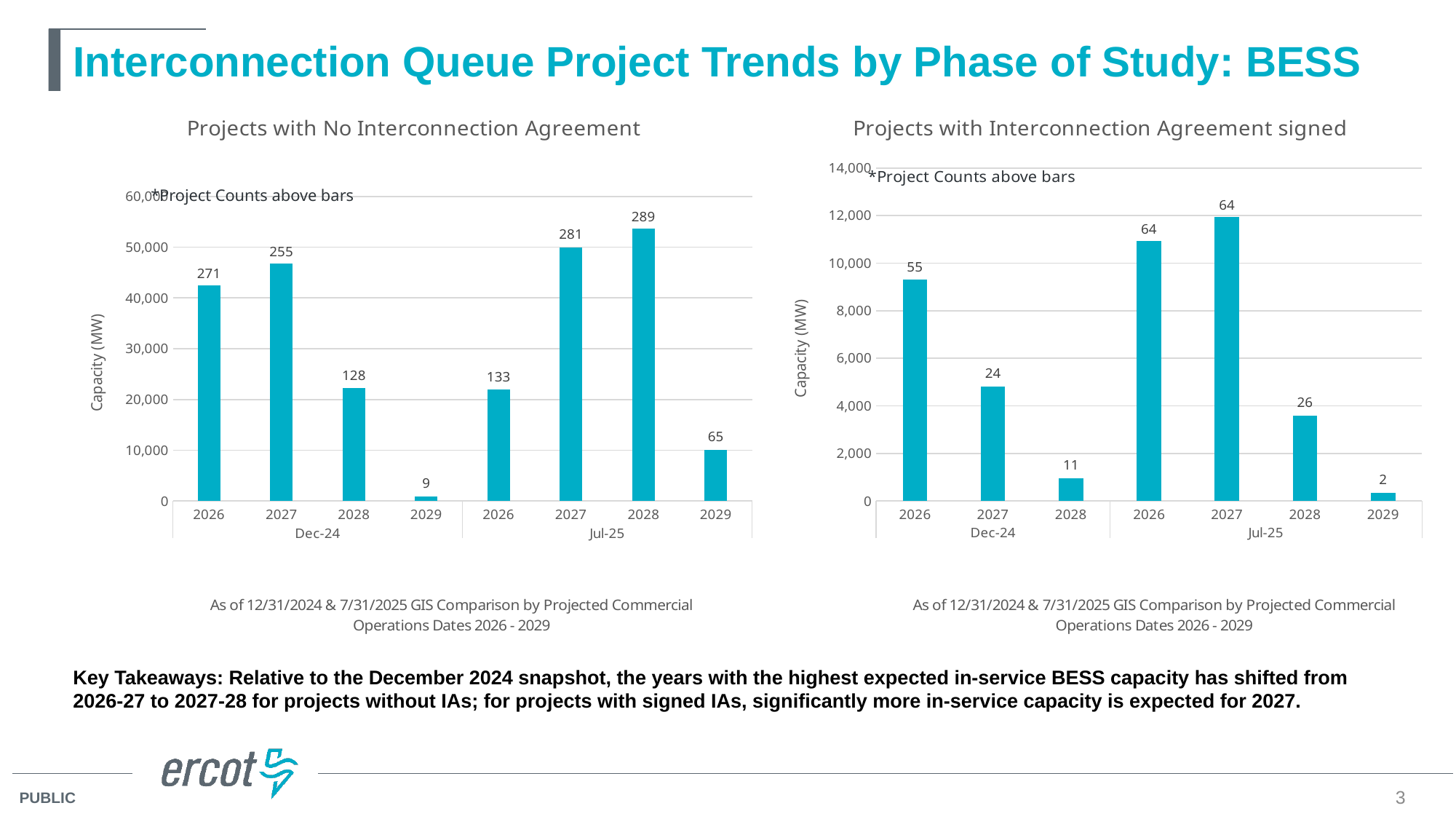
In the chart titled "Projects with Interconnection Agreement signed", is the capacity for 2027 in the Jul-25 group greater or less than 10,000? greater In the chart titled "Projects with No Interconnection Agreement", how many bars are plotted? 8 In the chart titled "Projects with Interconnection Agreement signed", how many bars are plotted? 7 In the chart titled "Projects with No Interconnection Agreement", is the capacity for 2026 in the Dec-24 group greater or less than 40,000? greater What kind of chart is the chart titled "Projects with No Interconnection Agreement"? bar chart In the chart titled "Projects with No Interconnection Agreement", what project count is printed above the 2028 bar in the Jul-25 group? 289 What is the y-axis label on the chart titled "Projects with Interconnection Agreement signed"? Capacity (MW) In the chart titled "Projects with Interconnection Agreement signed", which bar has the lowest capacity? 2029 in the Jul-25 group In the chart titled "Projects with No Interconnection Agreement", which bar has the highest capacity? 2028 in the Jul-25 group In the chart titled "Projects with Interconnection Agreement signed", what project count is printed above the 2027 bar in the Dec-24 group? 24 In the chart titled "Projects with Interconnection Agreement signed", which has the larger capacity: 2026 in the Dec-24 group or 2026 in the Jul-25 group? 2026 in the Jul-25 group In the chart titled "Projects with No Interconnection Agreement", what is the difference between the project count printed above the 2028 bar in the Jul-25 group and the project count printed above the 2028 bar in the Dec-24 group? 161